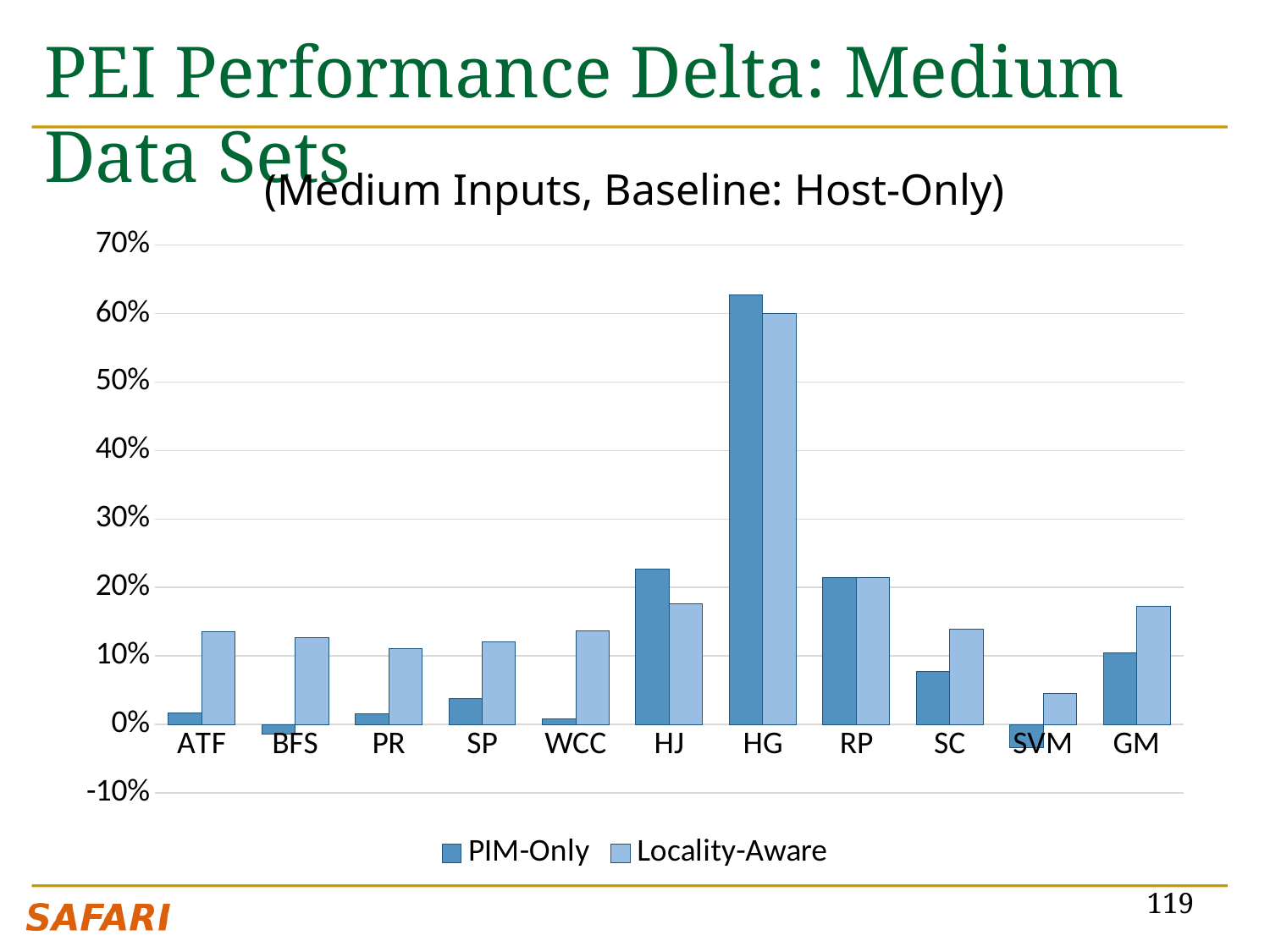
Which category has the lowest Locality-Aware value? SVM Is the PIM-Only value for SC greater or less than 10%? less What kind of chart is shown on the slide? bar chart Is the PIM-Only value for HG greater or less than 60%? greater Which category has the highest PIM-Only value? HG What is the chart's title text shown above the plot area? (Medium Inputs, Baseline: Host-Only) How many categories are shown along the x axis? 11 Is the Locality-Aware value for GM greater or less than 20%? less For HJ, which is larger: the PIM-Only value or the Locality-Aware value? PIM-Only Which category has the highest Locality-Aware value? HG For ATF, which is larger: the PIM-Only value or the Locality-Aware value? Locality-Aware How many series does the legend list? 2